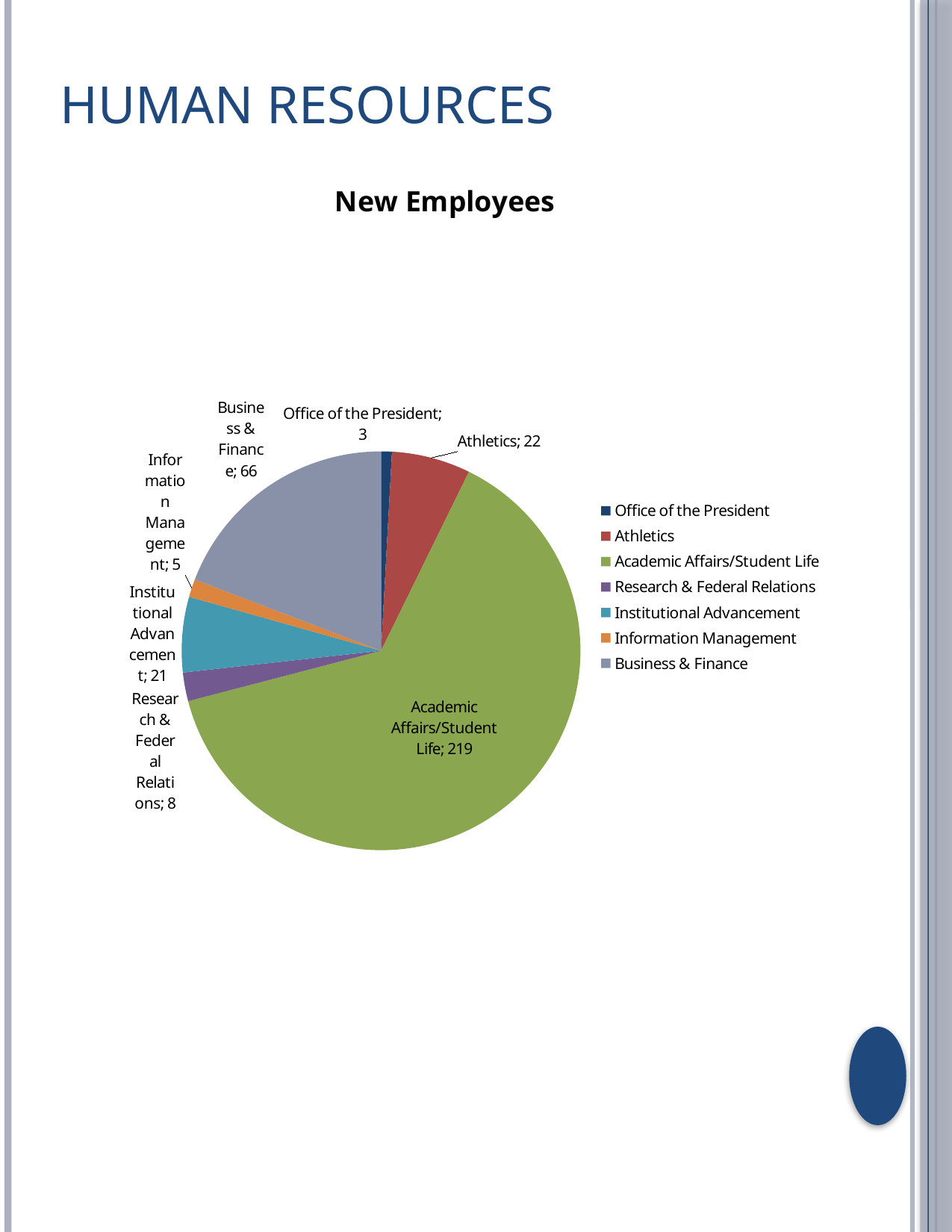
What is the difference between the number of new employees in Business & Finance and in Athletics? 44 How many categories does the pie chart show? 7 Which has more new employees, Research & Federal Relations or Information Management? Research & Federal Relations What is the title of the chart? New Employees How many new employees are shown for Institutional Advancement? 21 How many new employees are shown for Academic Affairs/Student Life? 219 What is the total number of new employees across all categories in the pie chart? 344 What kind of chart is shown on the slide? Pie chart Which category has the largest slice of the pie? Academic Affairs/Student Life How many new employees are shown for the Office of the President? 3 How many new employees are shown for Business & Finance? 66 Which category has the smallest slice of the pie? Office of the President